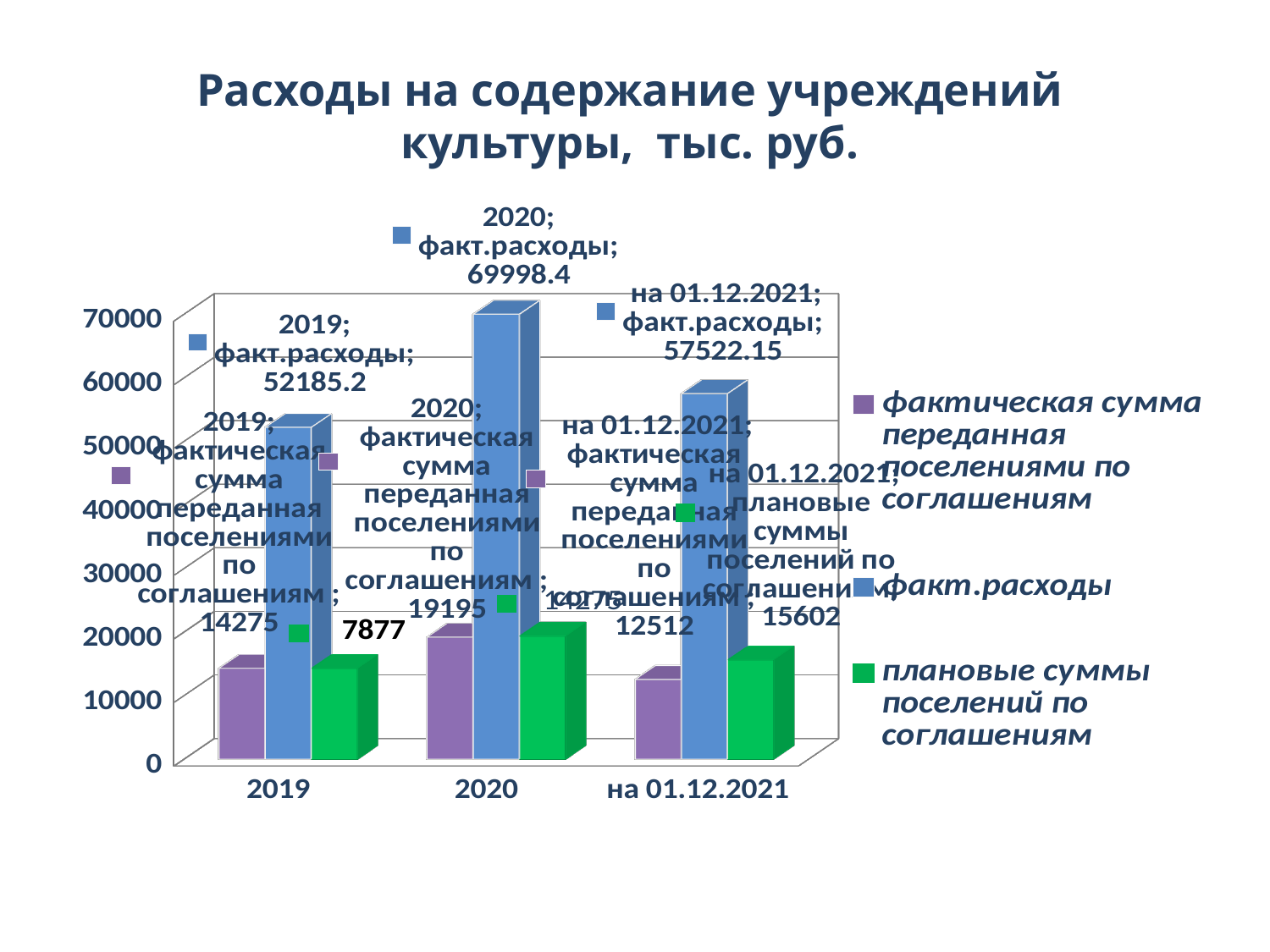
What kind of chart is shown on the slide? bar chart By how much did факт.расходы increase from 2019 to 2020? 17813.2 What is the value of фактическая сумма переданная поселениями по соглашениям for 2020? 19195 What is the value of плановые суммы поселений по соглашениям for на 01.12.2021? 15602 Which is larger: фактическая сумма переданная поселениями по соглашениям for 2019 or for на 01.12.2021? 2019 What is the value of факт.расходы for 2020? 69998.4 How many series does the legend list? 3 How many categories are shown on the x axis? 3 Which category has the highest факт.расходы? 2020 Which category has the lowest факт.расходы? 2019 What is the value of факт.расходы for на 01.12.2021? 57522.15 What is the value of факт.расходы for 2019? 52185.2